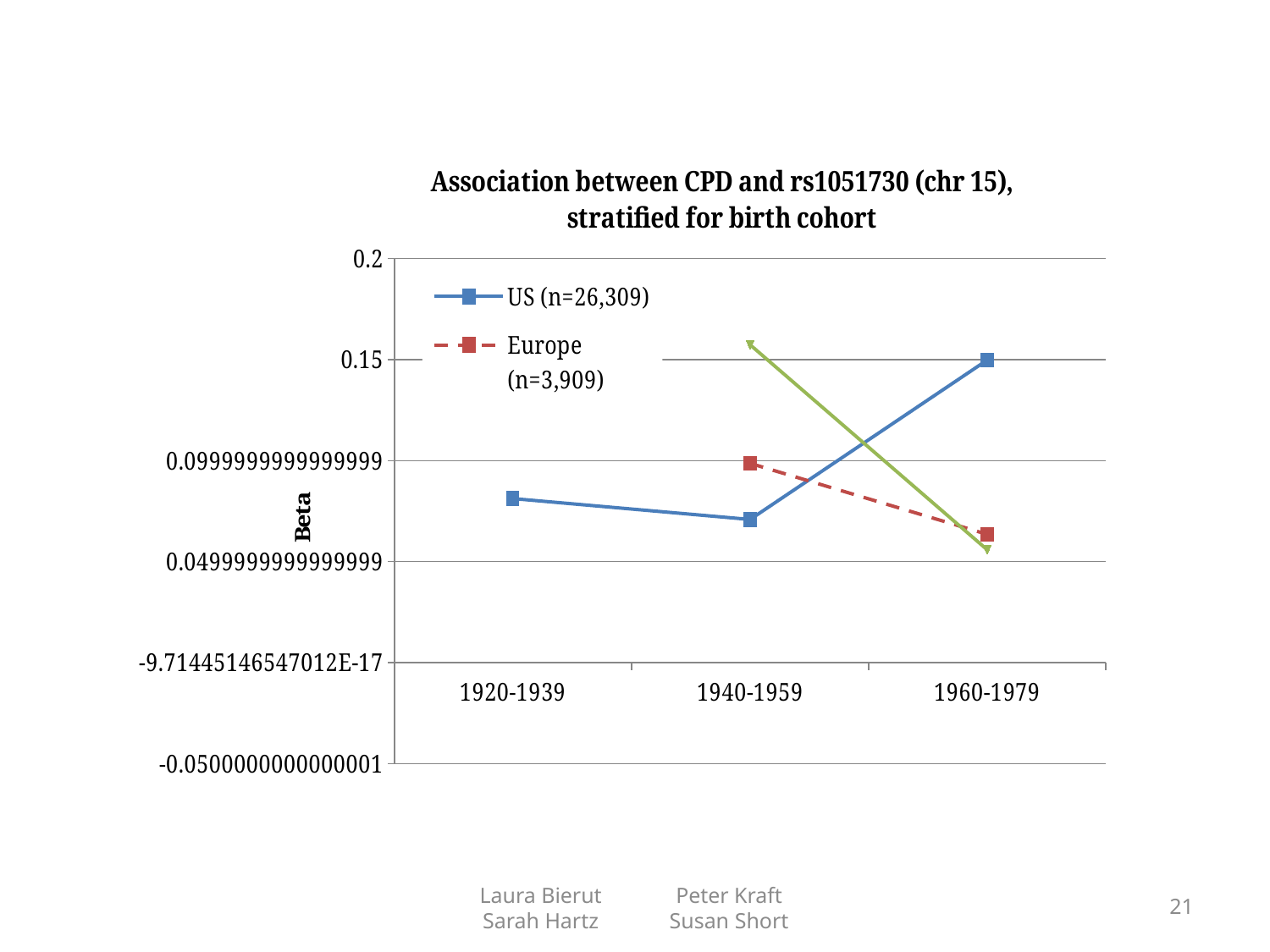
Is the Beta for Europe (n=3,909) at 1960-1979 greater or less than 0.0499999999999999? greater How many birth cohort categories are shown on the x axis? 3 What kind of chart is shown on the slide? line chart Does the US (n=26,309) series rise or fall from 1940-1959 to 1960-1979? rise Is the Beta for US (n=26,309) at 1920-1939 greater or less than 0.15? less Does the Europe (n=3,909) series rise or fall from 1940-1959 to 1960-1979? fall At 1960-1979, which series has the larger Beta, US (n=26,309) or Europe (n=3,909)? US (n=26,309) For which birth cohort is the US (n=26,309) Beta lowest? 1940-1959 For which birth cohort is the US (n=26,309) Beta highest? 1960-1979 What is the label of the y axis? Beta Is the Beta for US (n=26,309) at 1960-1979 greater or less than 0.0999999999999999? greater How many series does the legend list? 2